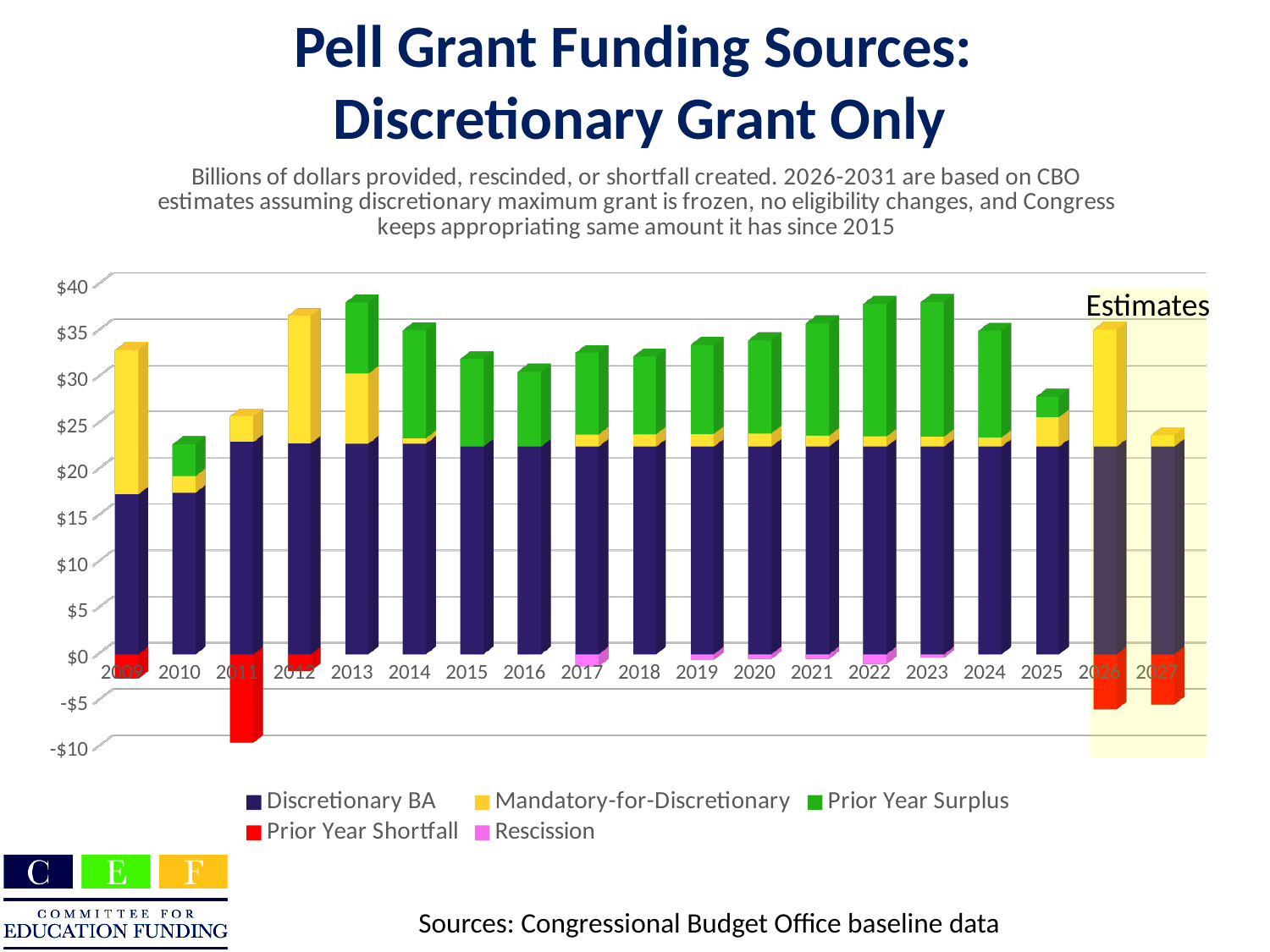
Is the Discretionary BA value for 2015 greater or less than $20? greater What kind of chart is shown on the slide? Stacked bar chart How many series does the legend list? 5 Is the Discretionary BA value for 2009 greater or less than $20? less Is the Mandatory-for-Discretionary value for 2009 greater or less than $10? greater Which year has the largest Prior Year Shortfall? 2011 Does the Prior Year Surplus generally rise or fall from 2016 to 2023? rise How many years are shown on the x axis? 19 Which year has the largest Mandatory-for-Discretionary amount? 2009 Which year has the larger Prior Year Surplus, 2010 or 2013? 2013 Which years on the chart are marked as estimates? 2026 and 2027